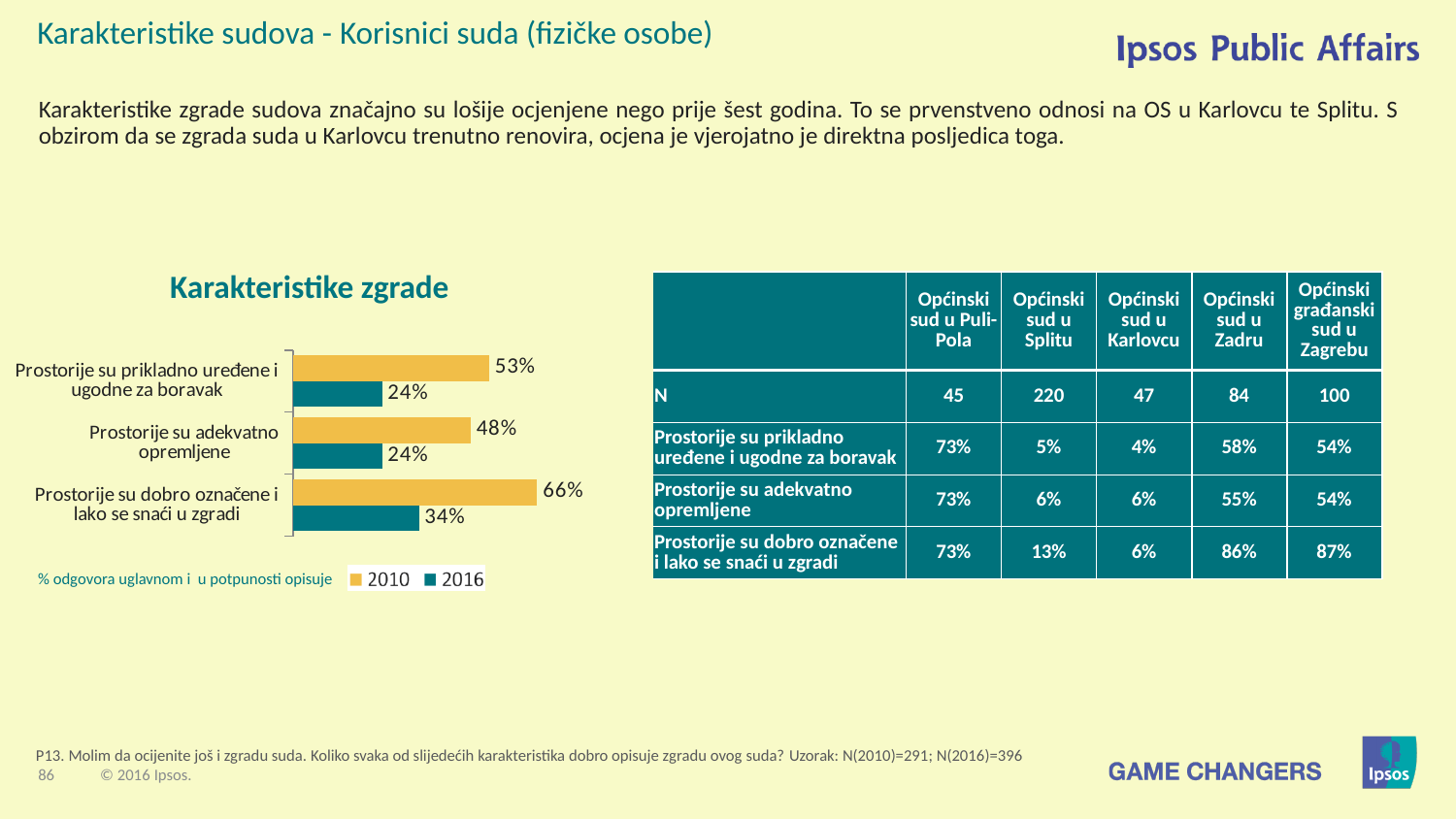
What is the 2016 value for "Prostorije su adekvatno opremljene" in the Karakteristike zgrade chart? 24% Which category has the highest 2010 value in the Karakteristike zgrade chart? Prostorije su dobro označene i lako se snaći u zgradi What is the 2016 value for "Prostorije su dobro označene i lako se snaći u zgradi" in the Karakteristike zgrade chart? 34% What is the difference between the 2010 and 2016 values for "Prostorije su prikladno uređene i ugodne za boravak" in the Karakteristike zgrade chart? 29% Which category has the lowest 2010 value in the Karakteristike zgrade chart? Prostorije su adekvatno opremljene In the Karakteristike zgrade chart, which is larger for "Prostorije su adekvatno opremljene": the 2010 value or the 2016 value? 2010 How many series does the legend of the Karakteristike zgrade chart list? 2 How many categories are shown in the Karakteristike zgrade chart? 3 What is the 2010 value for "Prostorije su prikladno uređene i ugodne za boravak" in the Karakteristike zgrade chart? 53% What is the difference between the 2010 and 2016 values for "Prostorije su dobro označene i lako se snaći u zgradi" in the Karakteristike zgrade chart? 32% Which series is shown in yellow in the Karakteristike zgrade chart? 2010 What type of chart is the Karakteristike zgrade chart? Bar chart